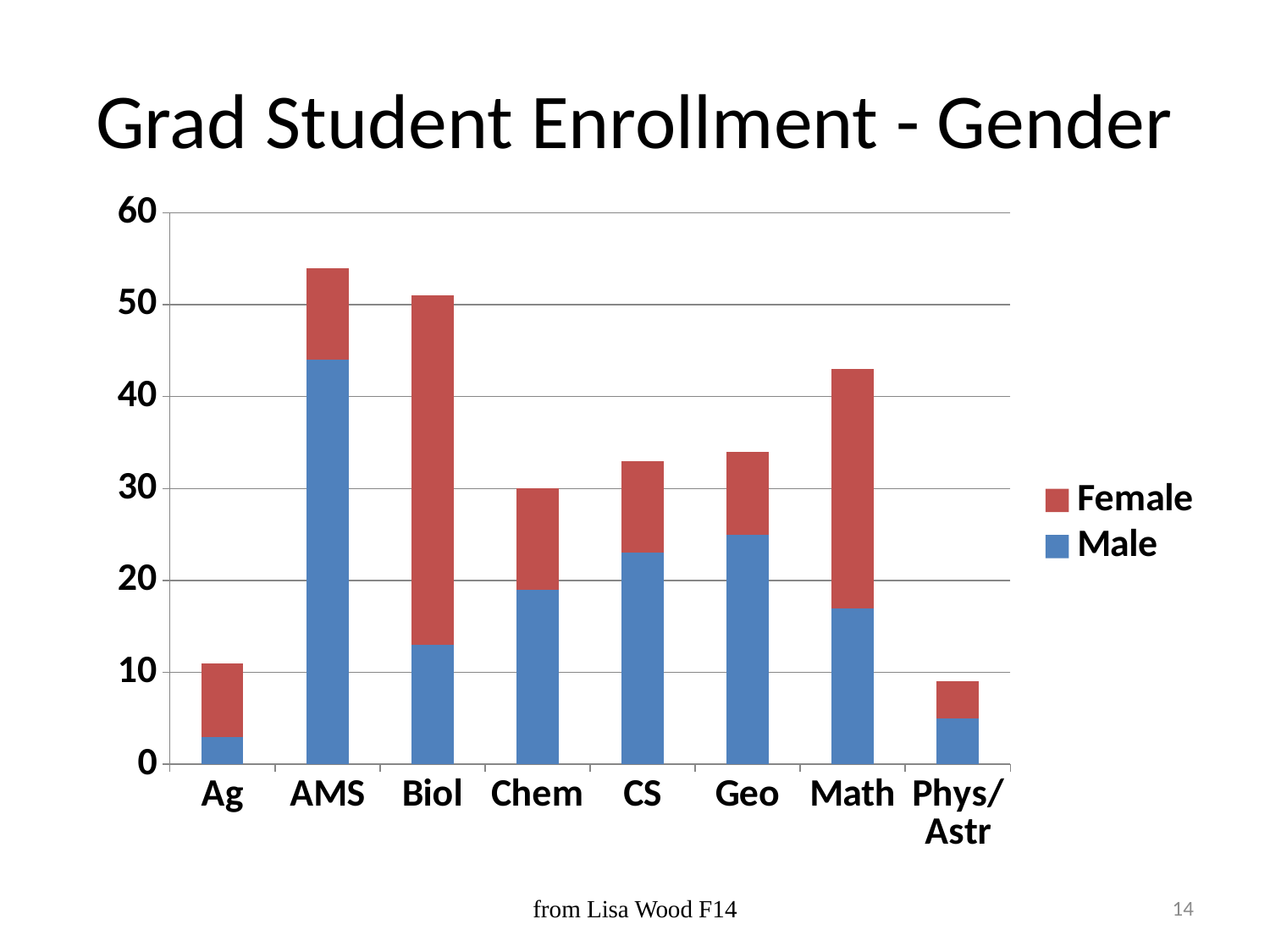
Is the total enrollment for AMS greater or less than 50? greater How many departments (categories) are shown on the x axis? 8 What kind of chart is shown on the slide? bar chart Which is larger, the Female enrollment for Biol or for AMS? Biol Is the total enrollment for Math greater or less than 40? greater How many series does the legend list? 2 Is the total enrollment for Phys/Astr greater or less than 10? less Which series does the legend list first? Female Which is larger, the total enrollment for Math or for Geo? Math Which department has the highest Male enrollment? AMS What is the title of the chart? Grad Student Enrollment - Gender